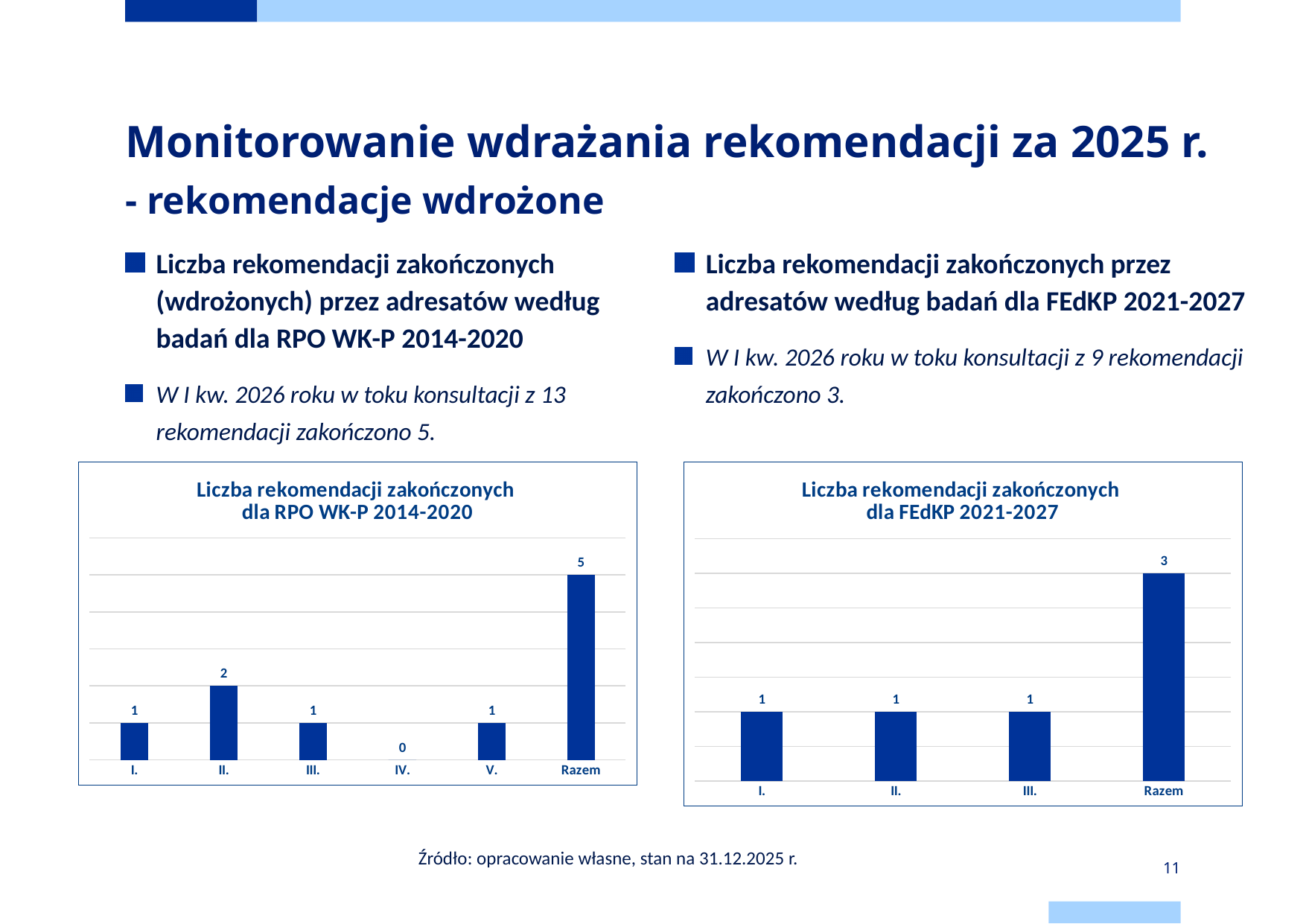
In the chart titled "Liczba rekomendacji zakończonych dla RPO WK-P 2014-2020", which is larger, the value for II. or the value for III.? II. What kind of chart is the chart titled "Liczba rekomendacji zakończonych dla FEdKP 2021-2027"? Bar chart In the chart titled "Liczba rekomendacji zakończonych dla RPO WK-P 2014-2020", what is the value for Razem? 5 In the chart titled "Liczba rekomendacji zakończonych dla RPO WK-P 2014-2020", what is the difference between the values for Razem and II.? 3 In the chart titled "Liczba rekomendacji zakończonych dla RPO WK-P 2014-2020", what is the value for category II.? 2 In the chart titled "Liczba rekomendacji zakończonych dla RPO WK-P 2014-2020", what is the value for category IV.? 0 In the chart titled "Liczba rekomendacji zakończonych dla FEdKP 2021-2027", what is the value for Razem? 3 How many categories are shown on the x axis of the chart titled "Liczba rekomendacji zakończonych dla FEdKP 2021-2027"? 4 In the chart titled "Liczba rekomendacji zakończonych dla RPO WK-P 2014-2020", which category has the highest value? Razem In the chart titled "Liczba rekomendacji zakończonych dla RPO WK-P 2014-2020", which category has the lowest value? IV. How many categories are shown on the x axis of the chart titled "Liczba rekomendacji zakończonych dla RPO WK-P 2014-2020"? 6 In the chart titled "Liczba rekomendacji zakończonych dla FEdKP 2021-2027", what is the value for category III.? 1